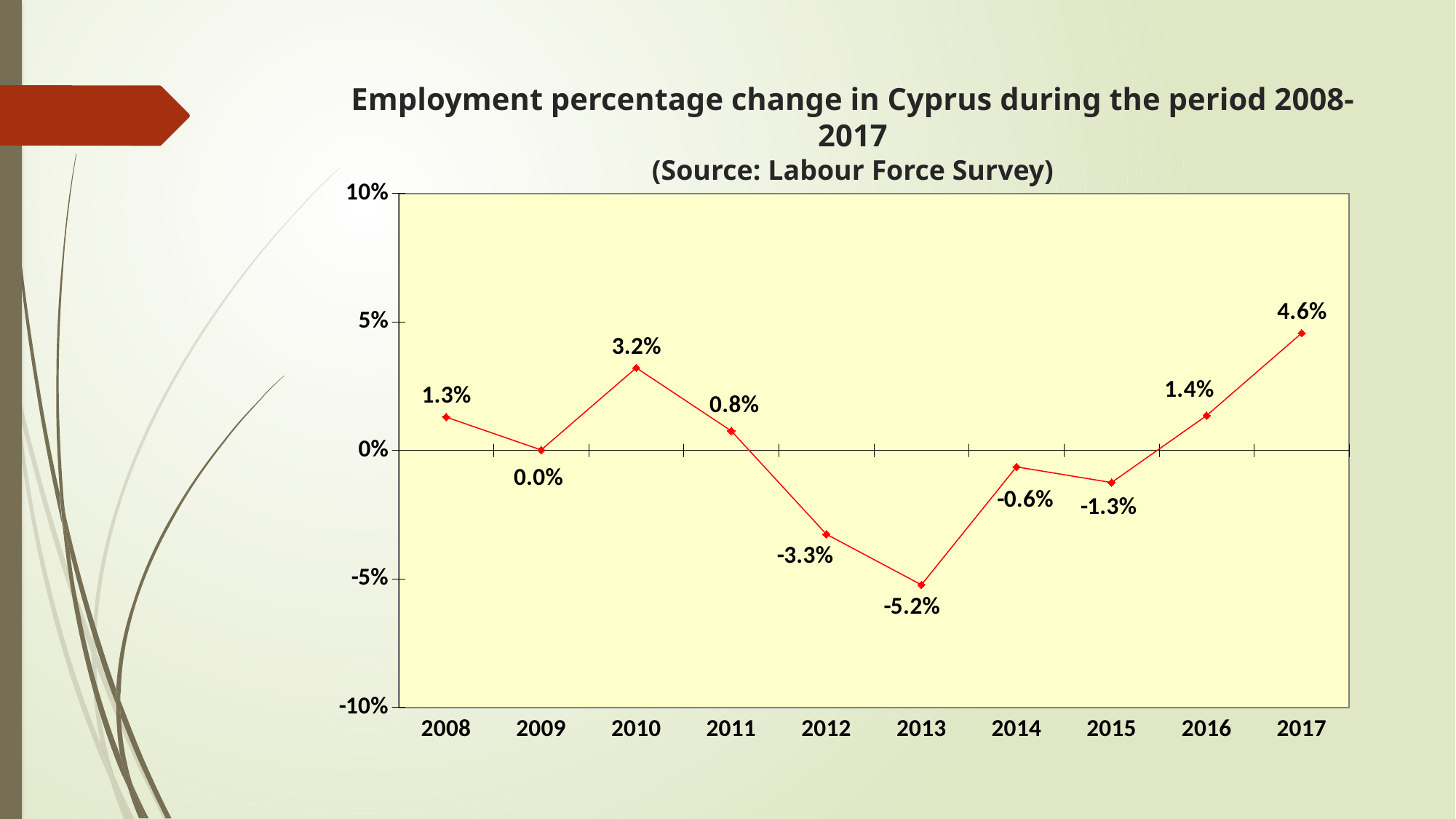
What is the employment percentage change in Cyprus for 2010? 3.2% Which year has the lowest employment percentage change? 2013 Which year has the highest employment percentage change? 2017 What is the employment percentage change in Cyprus for 2013? -5.2% What is the difference between the employment percentage change in 2017 and in 2016? 3.2% What is the employment percentage change in Cyprus for 2009? 0.0% What kind of chart is shown on the slide? Line chart Do the values rise or fall from 2013 to 2017? Rise Is the value for 2017 greater or less than 0%? greater What is the source of the data cited in the chart title? Labour Force Survey How many years are plotted on the chart? 10 Which year has a larger employment percentage change, 2012 or 2014? 2014